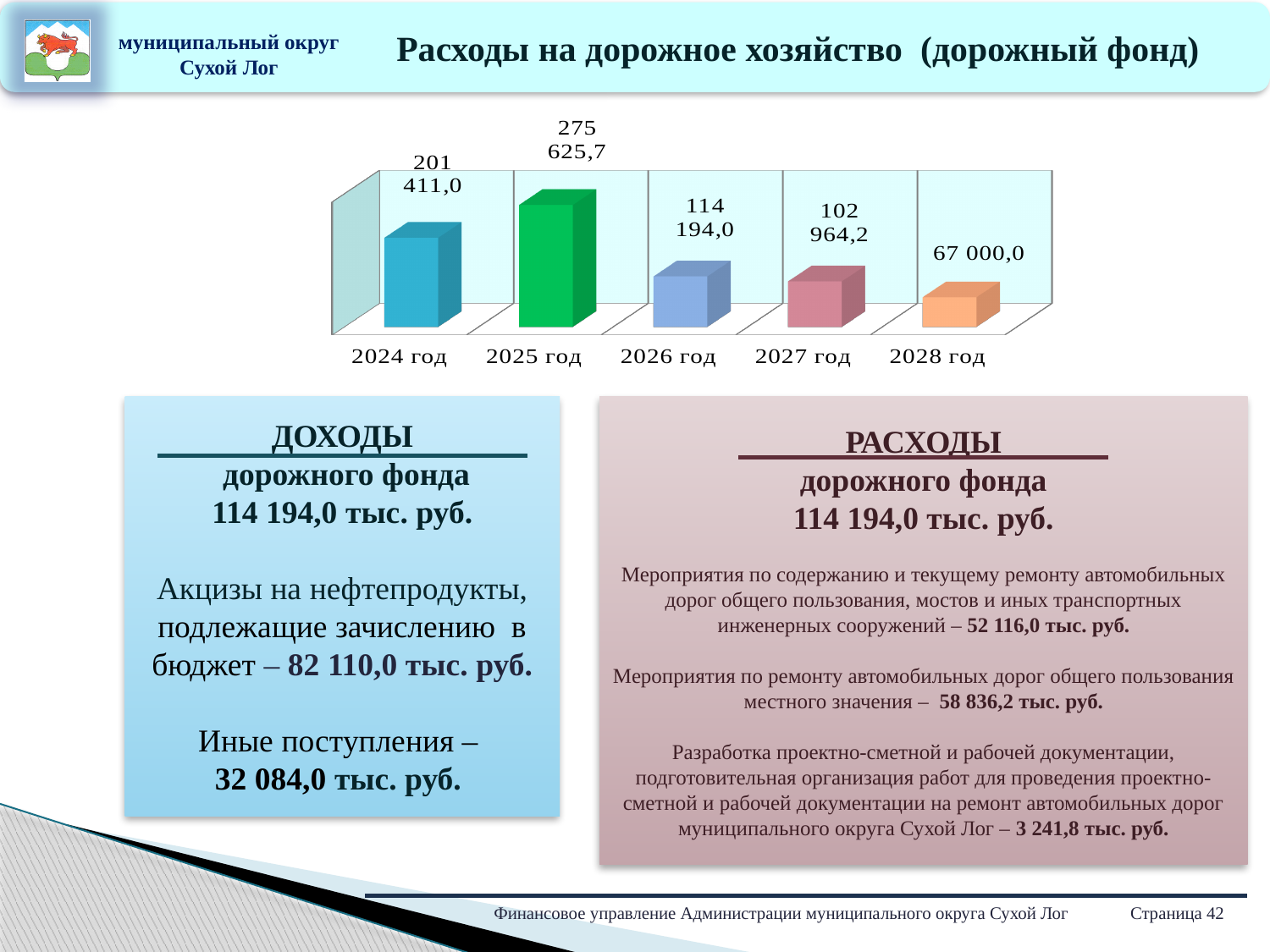
Which year has the highest value in the chart? 2025 год What is the difference between the values for 2025 год and 2024 год? 74 214,7 What is the value shown for 2026 год? 114 194,0 Which is larger, the value for 2026 год or the value for 2027 год? 2026 год What is the difference between the values for 2027 год and 2028 год? 35 964,2 How many years are shown in the chart? 5 What is the value shown for 2025 год? 275 625,7 Which year has the lowest value in the chart? 2028 год What kind of chart is shown on the slide? Bar chart What is the value shown for 2028 год? 67 000,0 What is the value shown for 2024 год? 201 411,0 What is the value shown for 2027 год? 102 964,2